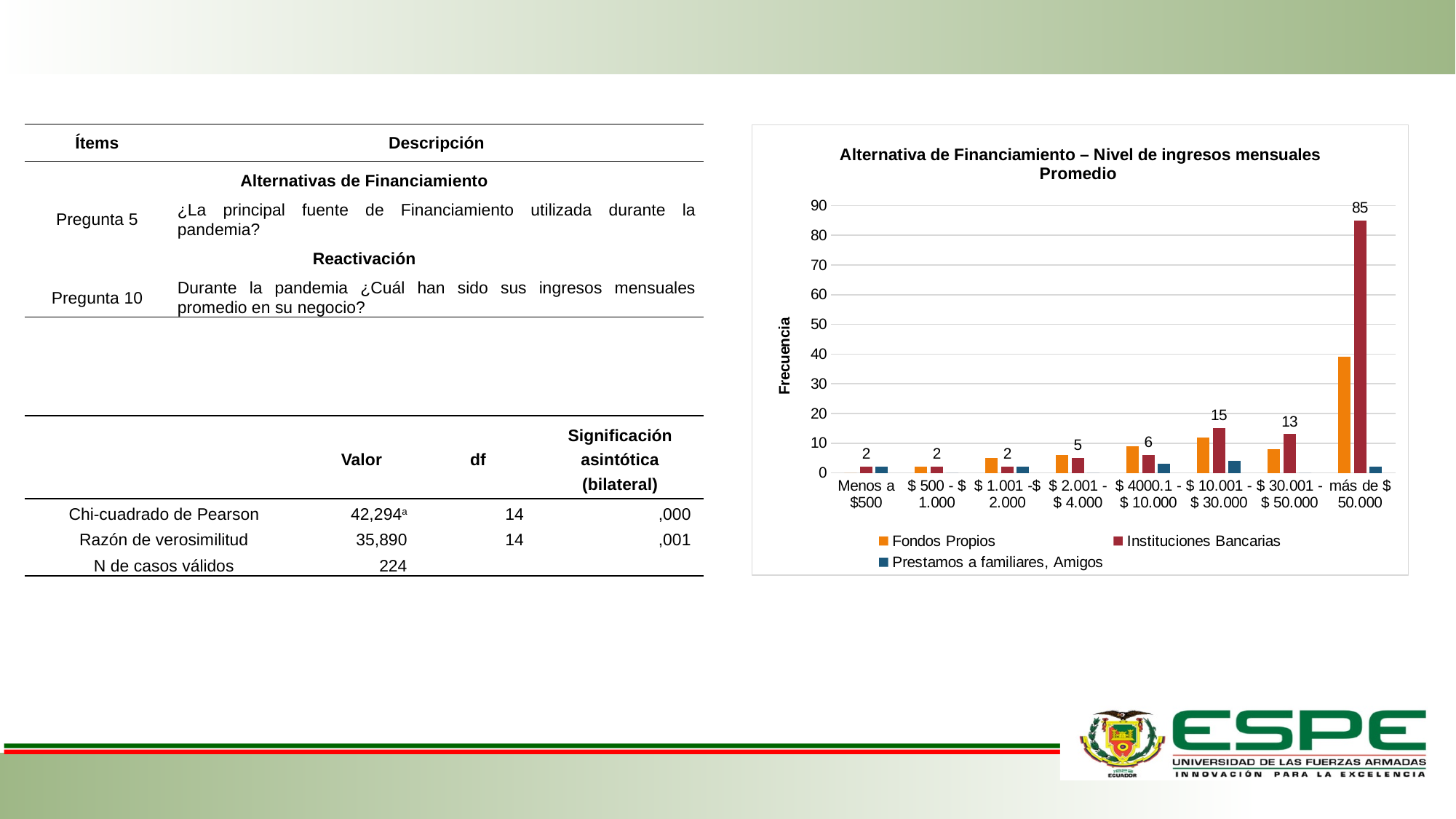
What kind of chart is shown on the slide? bar chart Is the value for Fondos Propios in the 'más de $ 50.000' category greater or less than 30? greater What is the difference between the Instituciones Bancarias values for 'más de $ 50.000' and '$ 30.001 - $ 50.000'? 72 What is the label of the vertical axis of the chart? Frecuencia How many series does the chart's legend list? 3 What is the value for Instituciones Bancarias in the 'más de $ 50.000' category? 85 How many income categories are shown on the x axis of the chart? 8 What is the value for Instituciones Bancarias in the '$ 10.001 - $ 30.000' category? 15 What is the difference between the Instituciones Bancarias values for '$ 10.001 - $ 30.000' and '$ 4000.1 - $ 10.000'? 9 For Instituciones Bancarias, which is larger: '$ 10.001 - $ 30.000' or '$ 30.001 - $ 50.000'? $ 10.001 - $ 30.000 What is the value for Instituciones Bancarias in the '$ 30.001 - $ 50.000' category? 13 Which income category has the highest value for Instituciones Bancarias? más de $ 50.000